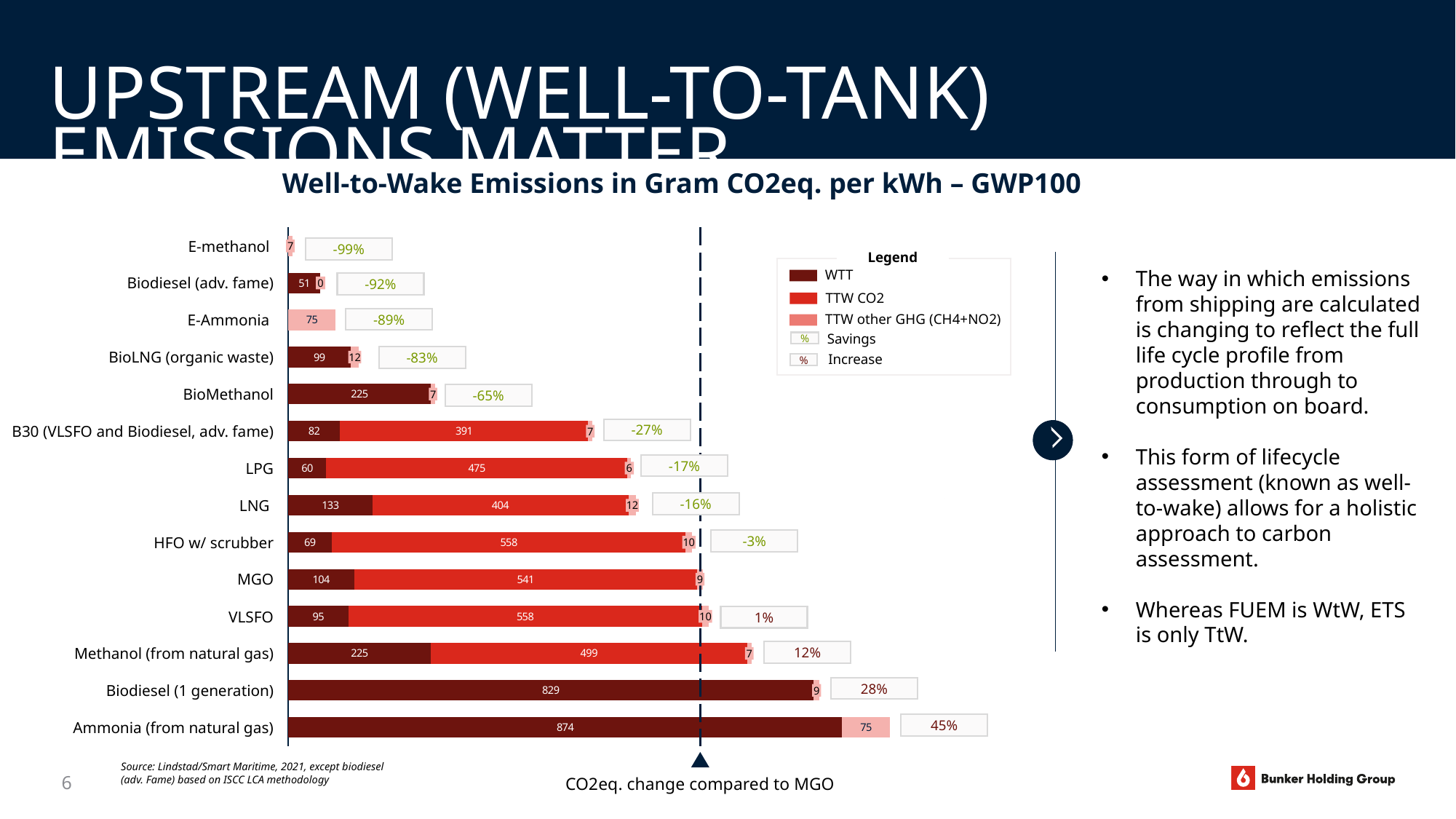
What is the TTW CO2 value for LPG? 475 What is the difference between the TTW CO2 value for HFO w/ scrubber and the TTW CO2 value for MGO? 17 How many fuel categories are shown in the chart? 14 What is the title of the chart? Well-to-Wake Emissions in Gram CO2eq. per kWh – GWP100 Which category shows the largest savings percentage compared to MGO? E-methanol What is the WTT value for LNG? 133 What kind of chart is shown on the slide? Stacked bar chart Which category has the largest WTT value? Ammonia (from natural gas) What percentage change compared to MGO is shown for BioLNG (organic waste)? -83% What percentage change compared to MGO is shown for Ammonia (from natural gas)? 45% Which has the larger WTT value, Methanol (from natural gas) or LNG? Methanol (from natural gas) What is the total of the stacked bar for MGO? 654